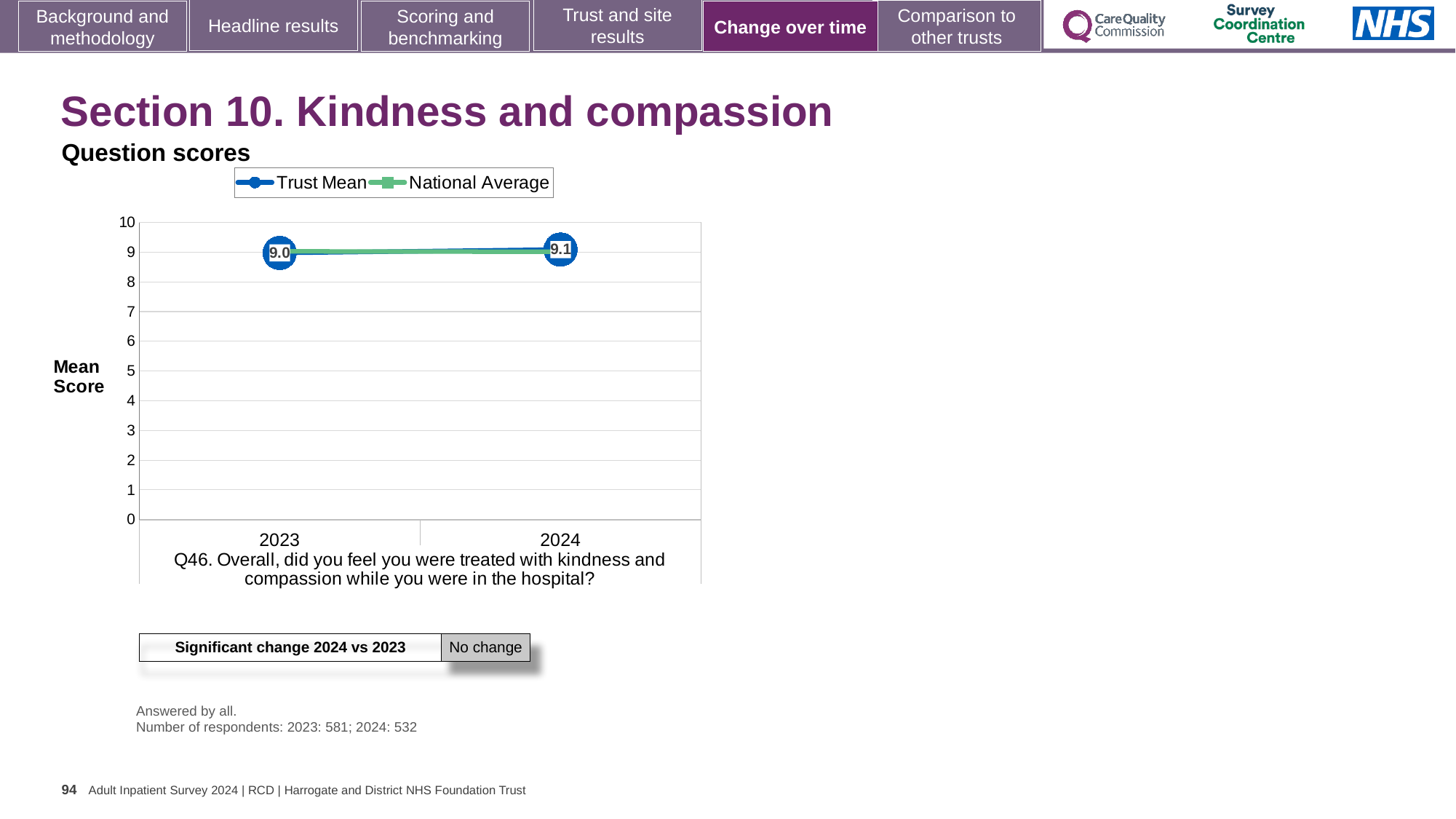
How many series does the chart legend list? 2 Which is larger, the Trust Mean score for 2023 or for 2024? 2024 In which year is the Trust Mean score lower? 2023 What is the label on the y axis of the chart? Mean Score What is the Trust Mean score for 2024? 9.1 In which year is the Trust Mean score higher? 2024 What is the difference between the Trust Mean scores for 2024 and 2023? 0.1 How many years are shown on the x axis of the chart? 2 What is the Trust Mean score for 2023? 9.0 What kind of chart is shown on the slide? Line chart Does the Trust Mean score rise or fall from 2023 to 2024? Rise Is the National Average value for 2024 greater or less than 5? greater